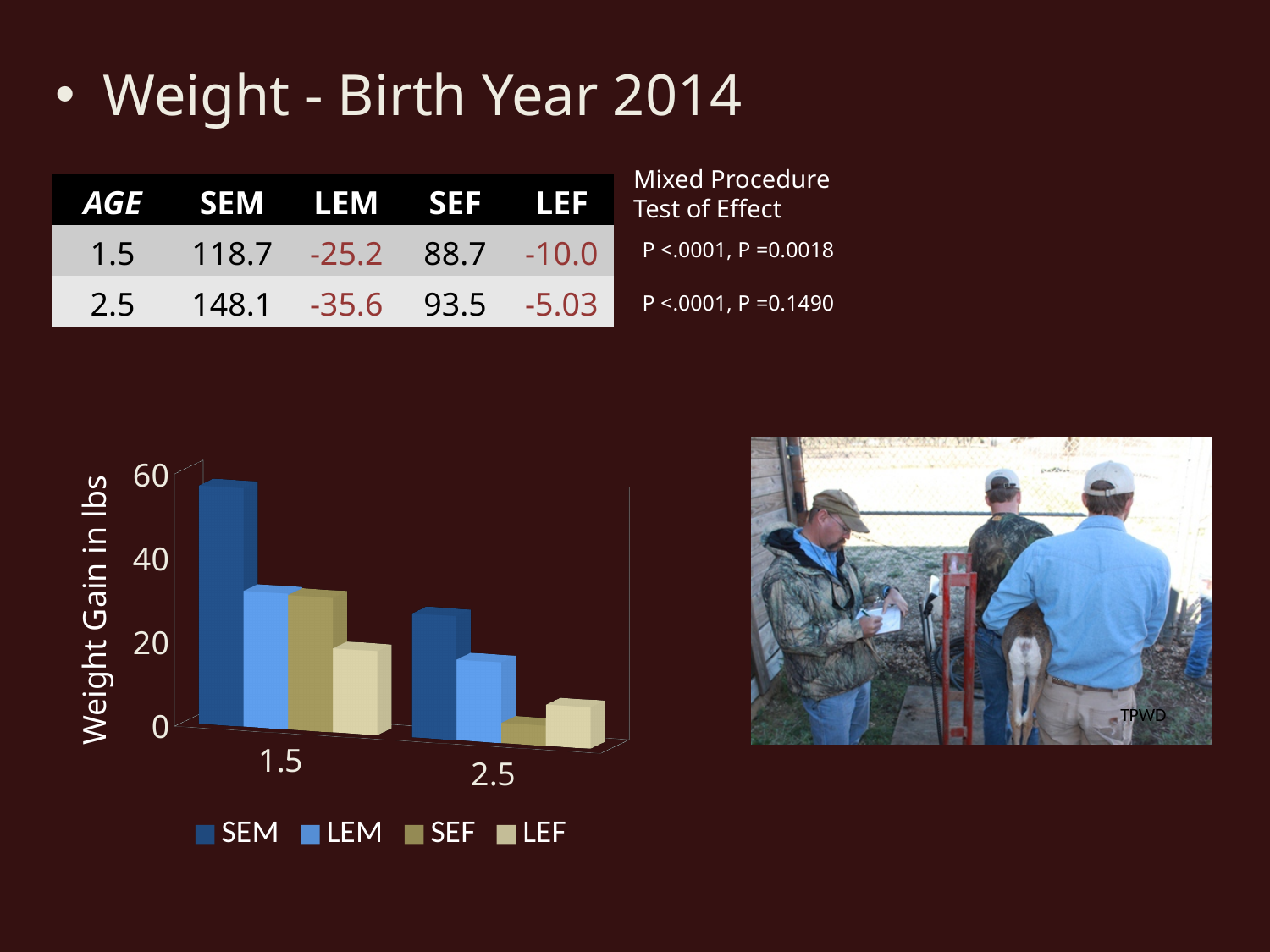
Which is larger in the chart: SEM at age 1.5 or SEM at age 2.5? SEM at age 1.5 Is the value for SEM at age 1.5 greater or less than 40? greater Does the SEM series rise or fall from age 1.5 to age 2.5? fall How many age categories are shown on the x axis of the chart? 2 Is the value for SEM at age 2.5 greater or less than 20? greater Is the value for LEM at age 1.5 greater or less than 20? greater What is the label of the chart's vertical axis? Weight Gain in lbs What kind of chart is shown on the slide? bar chart Which series has the shortest bar at age 2.5 in the chart? SEF Which series and age category has the tallest bar in the chart? SEM at 1.5 How many series does the chart's legend list? 4